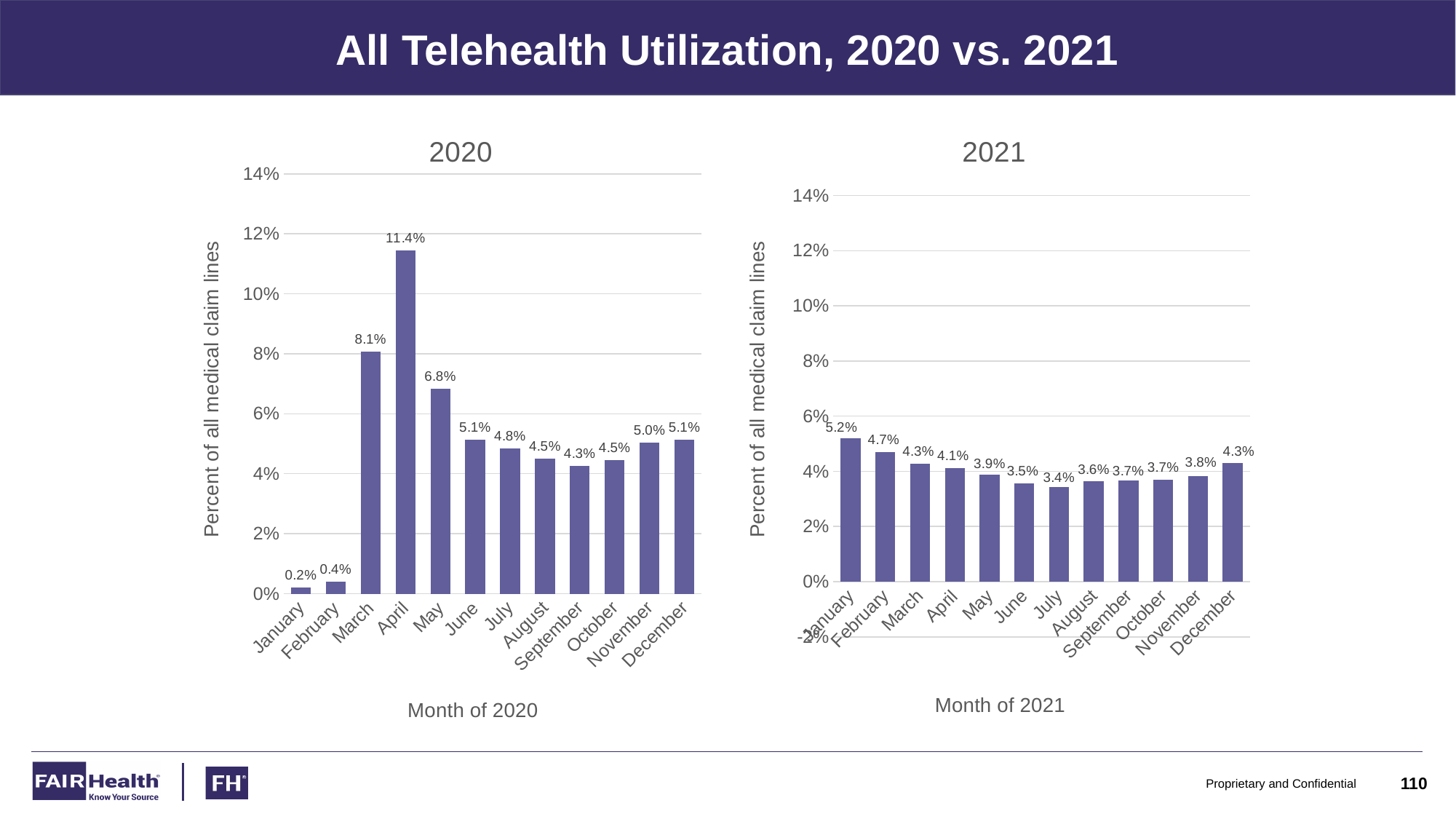
In the 2021 chart, what is the difference between the values for January and December? 0.9% Which is larger: the value for March in the 2020 chart or the value for March in the 2021 chart? March in the 2020 chart In the 2020 chart, which month has the lowest value? January In the 2020 chart, what is the difference between the values for April and March? 3.3% In the 2020 chart, what is the value for April? 11.4% In the 2020 chart, which month has the highest value? April In the 2021 chart, do the values rise or fall from January to July? Fall In the 2021 chart, what is the value for July? 3.4% In the 2021 chart, which month has the highest value? January In the 2021 chart, which month has the lowest value? July How many months are plotted in the 2021 chart? 12 What type of chart is the 2020 chart? Bar chart